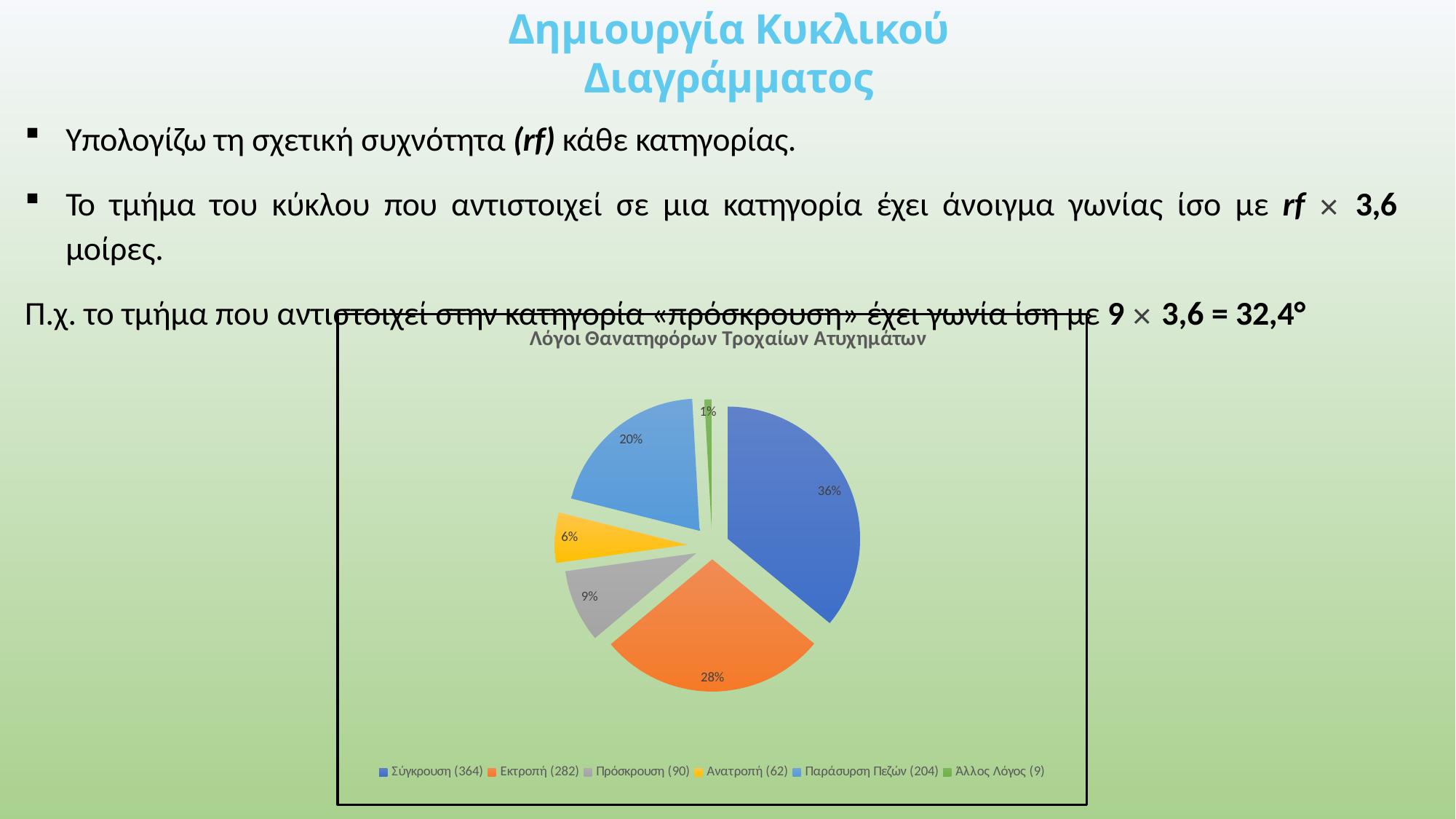
Which category has the smallest slice in the pie chart? Άλλος Λόγος What percentage share does the Σύγκρουση slice have in the pie chart? 36% What count is shown in the legend for the Παράσυρση Πεζών category? 204 What percentage share does the Πρόσκρουση slice have in the pie chart? 9% What is the title of the pie chart? Λόγοι Θανατηφόρων Τροχαίων Ατυχημάτων What percentage share does the Παράσυρση Πεζών slice have in the pie chart? 20% How many slices does the pie chart have? 6 Which category has the largest slice in the pie chart? Σύγκρουση What kind of chart is shown on the slide? pie chart Which slice is larger in the pie chart, Ανατροπή or Πρόσκρουση? Πρόσκρουση What is the difference in percentage points between the Σύγκρουση slice and the Εκτροπή slice? 8%